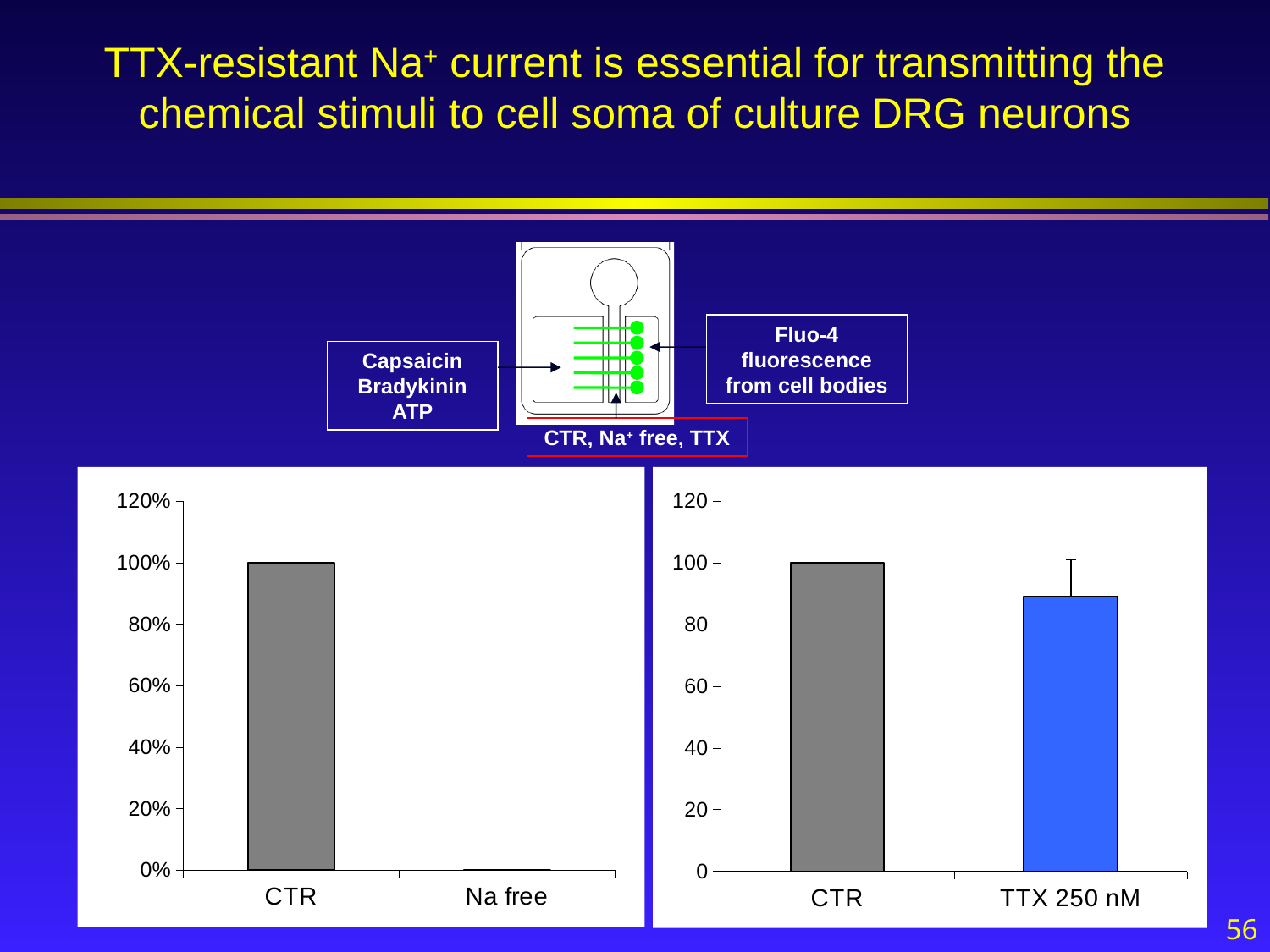
What kind of chart is the left chart on the slide? bar chart In the right chart, what is the value for CTR? 100 In the right chart, is the value for TTX 250 nM greater or less than 100? less In the right chart, is the value for TTX 250 nM greater or less than 80? greater In the right chart, which category has the highest value? CTR In the left chart, which category has the lowest value? Na free In the right chart, what colour is the bar for TTX 250 nM? blue How many categories are shown on the x axis of the left chart? 2 How many categories are shown on the x axis of the right chart? 2 In the left chart, what is the value for CTR? 100% In the left chart, is the value for Na free greater or less than 20%? less In the left chart, which is larger, the value for CTR or the value for Na free? CTR